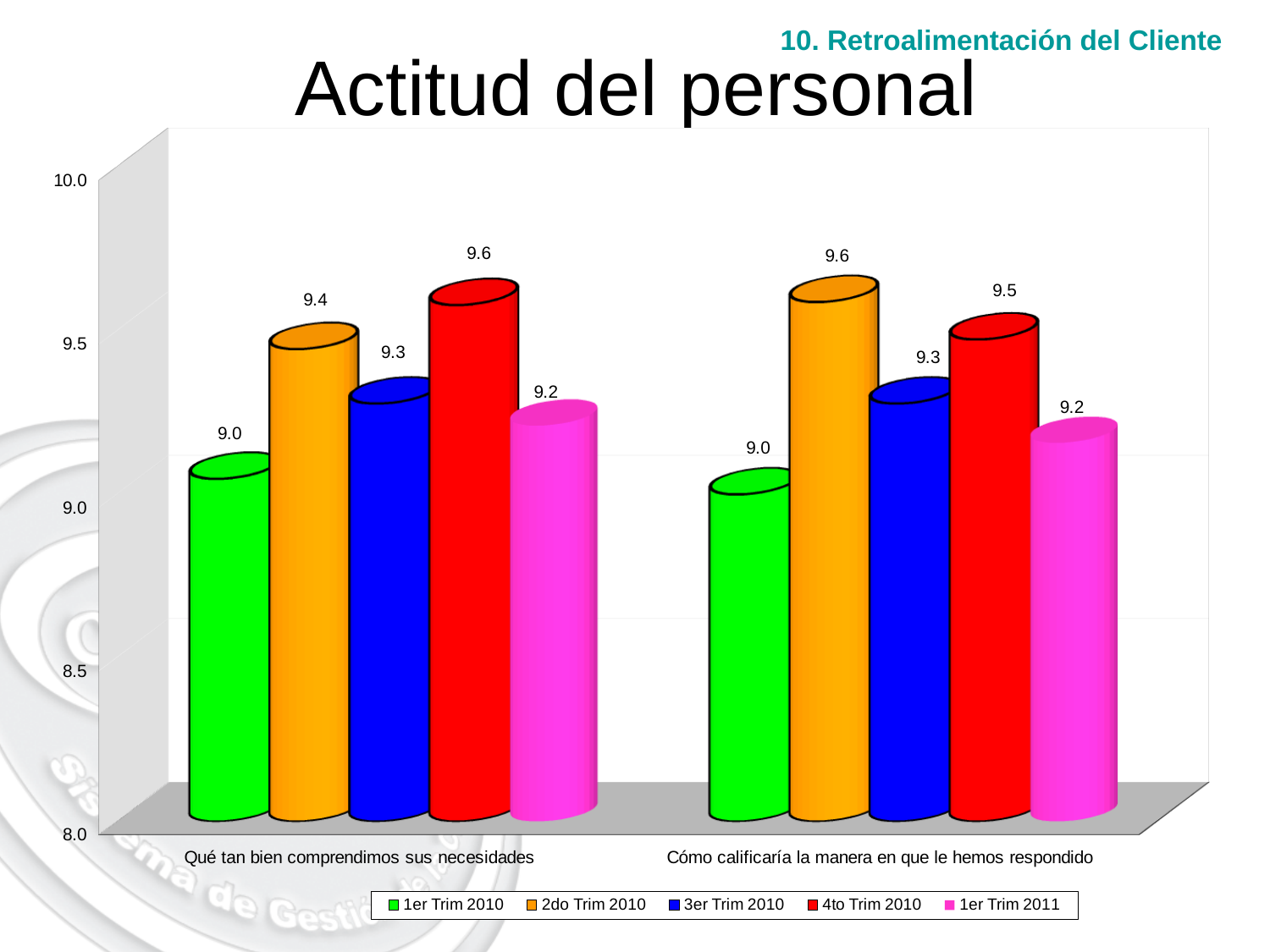
How many categories are shown on the x axis of the chart? 2 What is the value for 4to Trim 2010 in the category "Cómo calificaría la manera en que le hemos respondido"? 9.5 Which series has the lowest value in the category "Cómo calificaría la manera en que le hemos respondido"? 1er Trim 2010 Which series has the highest value in the category "Qué tan bien comprendimos sus necesidades"? 4to Trim 2010 Which series has the highest value in the category "Cómo calificaría la manera en que le hemos respondido"? 2do Trim 2010 What is the value for 1er Trim 2011 in the category "Qué tan bien comprendimos sus necesidades"? 9.2 What is the title of the chart on the slide? Actitud del personal What is the difference between the 4to Trim 2010 value and the 1er Trim 2010 value in the category "Qué tan bien comprendimos sus necesidades"? 0.6 How many series does the legend list? 5 Which is larger in the category "Cómo calificaría la manera en que le hemos respondido": the 2do Trim 2010 value or the 3er Trim 2010 value? 2do Trim 2010 What is the value for 2do Trim 2010 in the category "Qué tan bien comprendimos sus necesidades"? 9.4 What kind of chart is shown on the slide? Bar chart